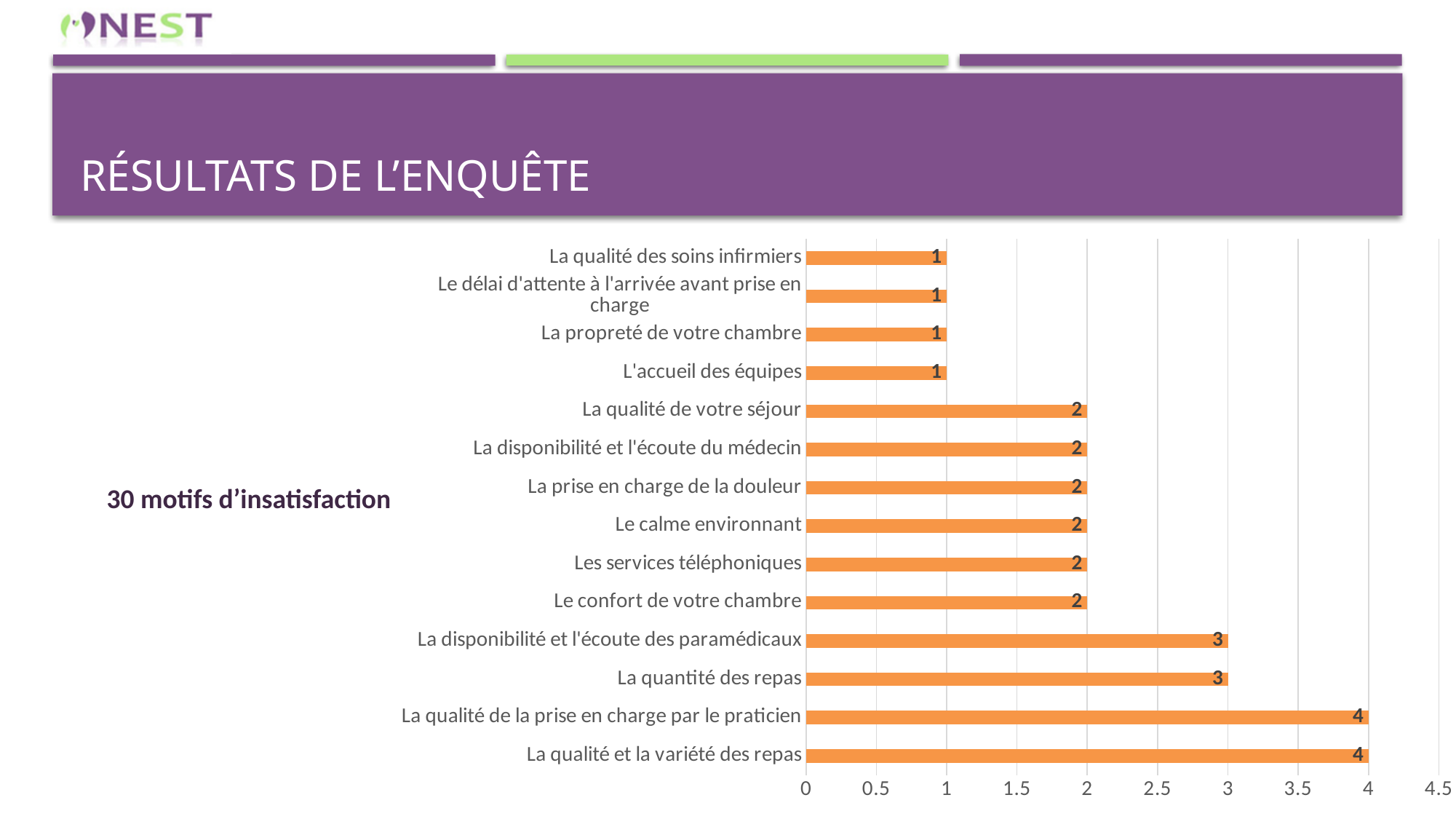
Is the value for "La qualité de la prise en charge par le praticien" greater or less than 3? greater What is the value for "La disponibilité et l'écoute des paramédicaux"? 3 What is the value for "La propreté de votre chambre"? 1 Which is larger: the value for "La qualité de votre séjour" or the value for "La qualité des soins infirmiers"? La qualité de votre séjour What is the difference between the value for "La qualité de la prise en charge par le praticien" and the value for "L'accueil des équipes"? 3 What is the difference between the value for "La quantité des repas" and the value for "Les services téléphoniques"? 1 What is the value for "La quantité des repas"? 3 What is the value for "La qualité et la variété des repas"? 4 What is the value for "Le calme environnant"? 2 What type of chart is shown on the slide? bar chart How many categories are plotted in the chart? 14 What text appears to the left of the chart on the slide? 30 motifs d’insatisfaction